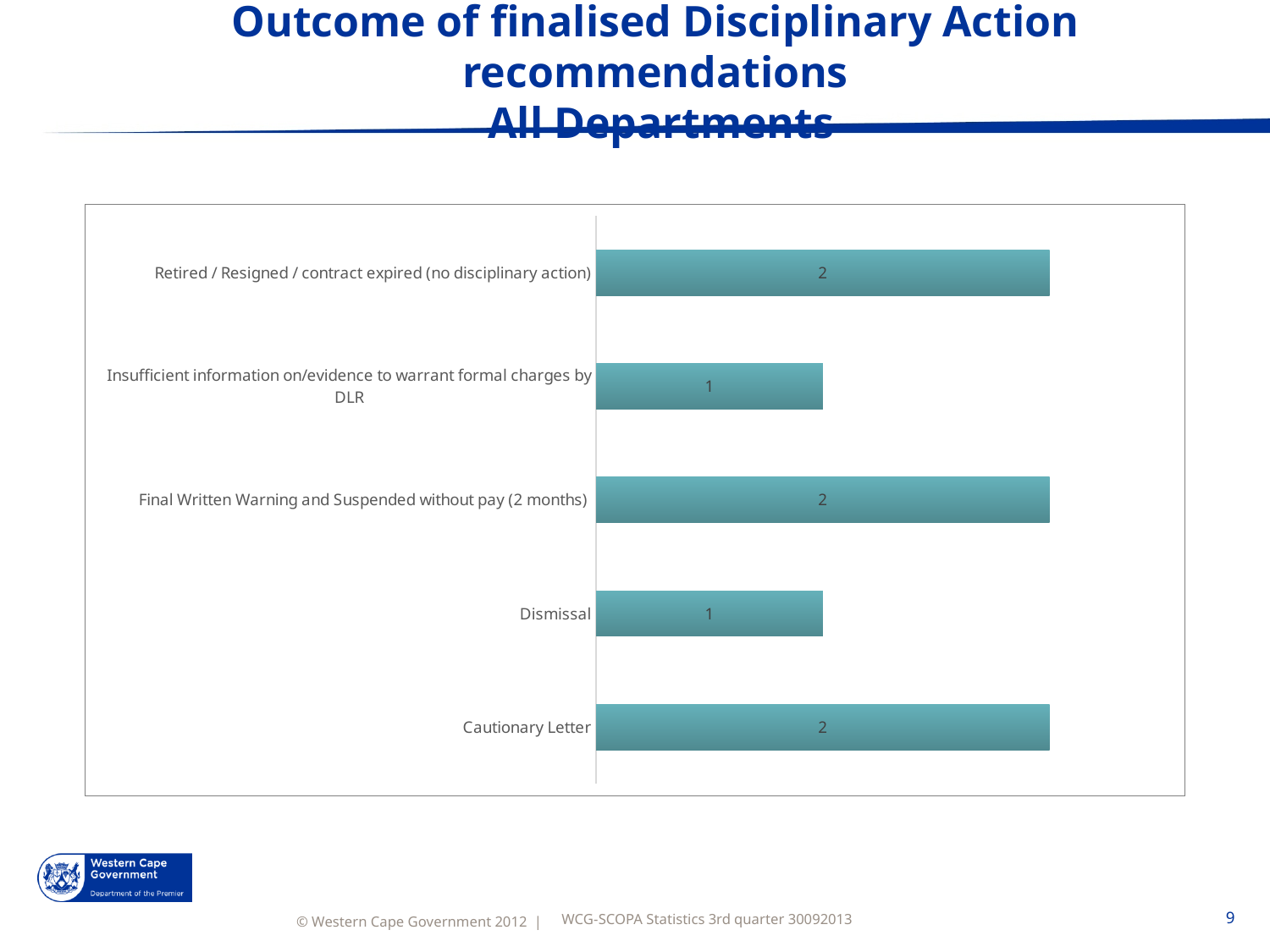
What is the value for Insufficient information on/evidence to warrant formal charges by DLR? 1 What is the title of the slide containing the chart? Outcome of finalised Disciplinary Action recommendations All Departments What is the difference between the value for Final Written Warning and Suspended without pay (2 months) and the value for Dismissal? 1 What is the value for Final Written Warning and Suspended without pay (2 months)? 2 What is the total of all the values shown in the chart? 8 What is the value for Cautionary Letter? 2 What kind of chart is shown on the slide? Bar chart How many categories are shown in the chart? 5 What is the value for Dismissal? 1 What is the value for Retired / Resigned / contract expired (no disciplinary action)? 2 Which is larger, the value for Retired / Resigned / contract expired (no disciplinary action) or the value for Insufficient information on/evidence to warrant formal charges by DLR? Retired / Resigned / contract expired (no disciplinary action) Which is larger, the value for Dismissal or the value for Cautionary Letter? Cautionary Letter